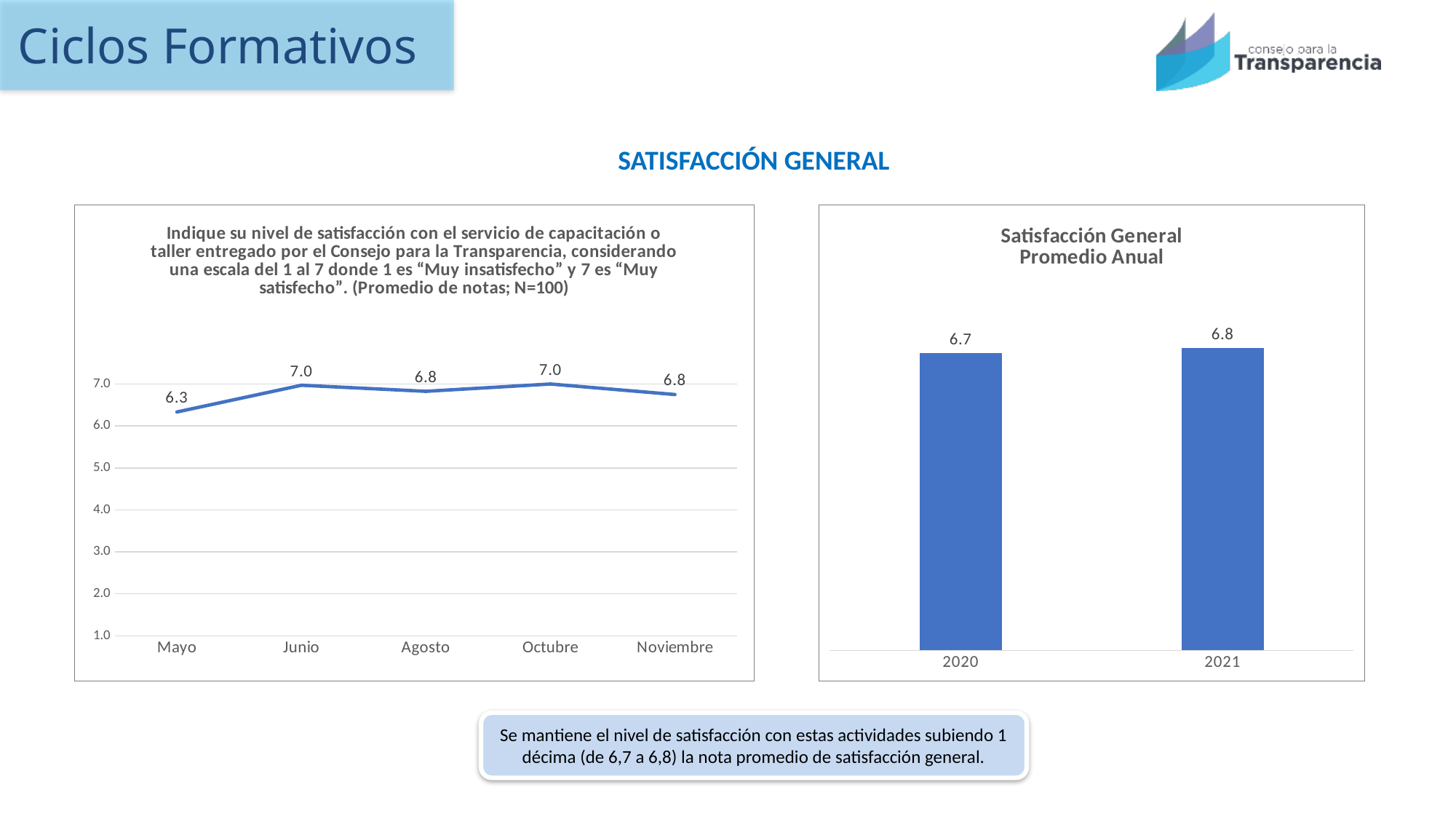
In the left line chart, what is the value for Mayo? 6.3 In the left line chart, what is the difference between the values for Junio and Mayo? 0.7 In the 'Satisfacción General Promedio Anual' chart, what is the value for 2021? 6.8 In the left line chart, how many months are plotted on the x axis? 5 What kind of chart is the 'Satisfacción General Promedio Anual' chart? bar chart In the 'Satisfacción General Promedio Anual' chart, what is the difference between 2021 and 2020? 0.1 In the 'Satisfacción General Promedio Anual' chart, how many years are shown? 2 What kind of chart is the chart on the left? line chart In the left line chart, is the value for Mayo greater or less than 6.0? greater In the left line chart, which month has the lowest value? Mayo In the left line chart, what is the value for Agosto? 6.8 In the 'Satisfacción General Promedio Anual' chart, what is the value for 2020? 6.7